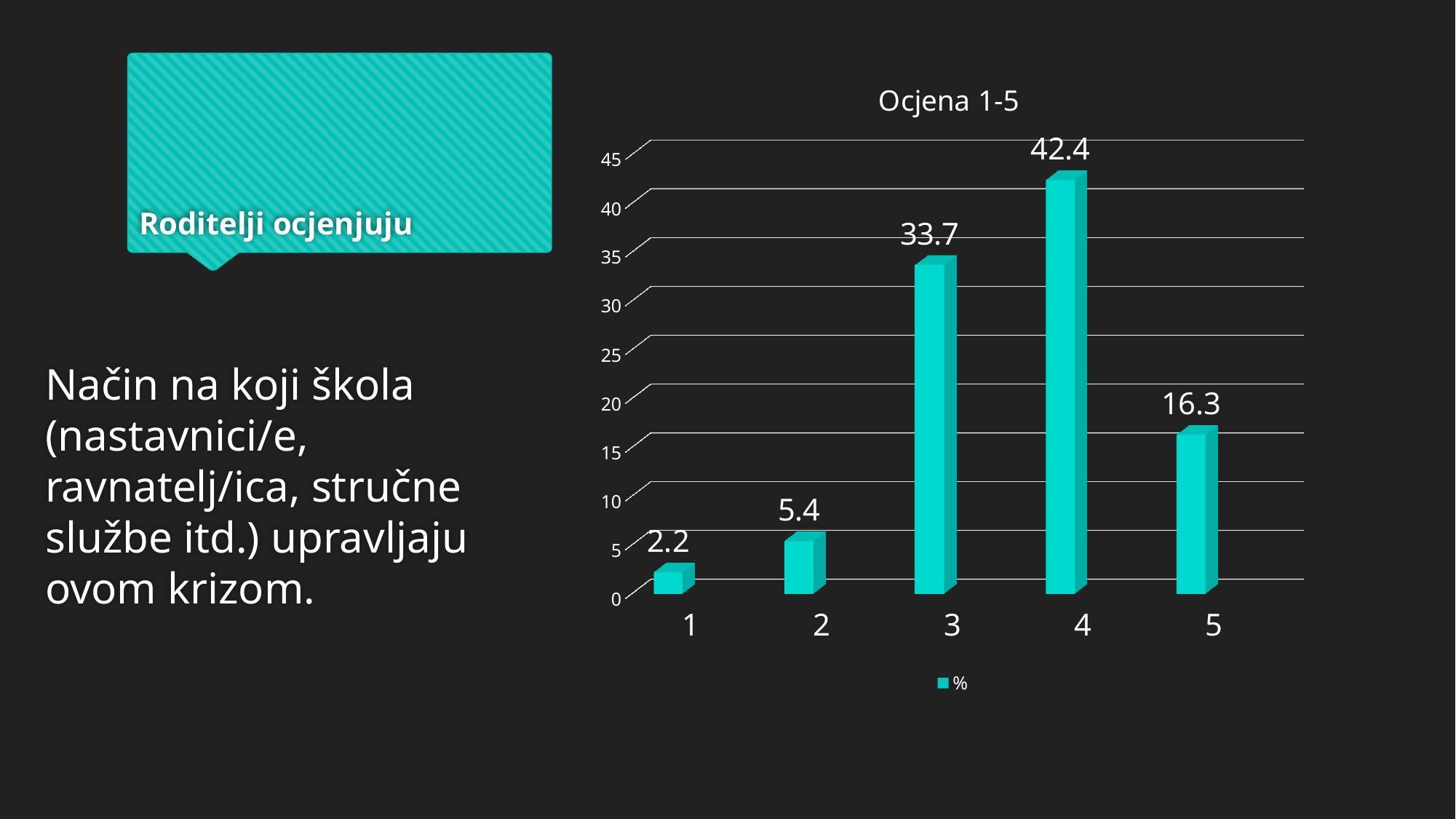
What is the value for category 4? 42.4 Which is larger, the value for category 3 or the value for category 5? 3 Which category has the highest value? 4 Is the value for category 3 greater or less than 30? greater How many categories are shown on the x axis? 5 What is the value for category 1? 2.2 What kind of chart is shown? bar chart What is the value for category 5? 16.3 What is the difference between the values for category 5 and category 2? 10.9 What is the difference between the values for category 4 and category 3? 8.7 Which category has the lowest value? 1 What is the title of the chart? Ocjena 1-5